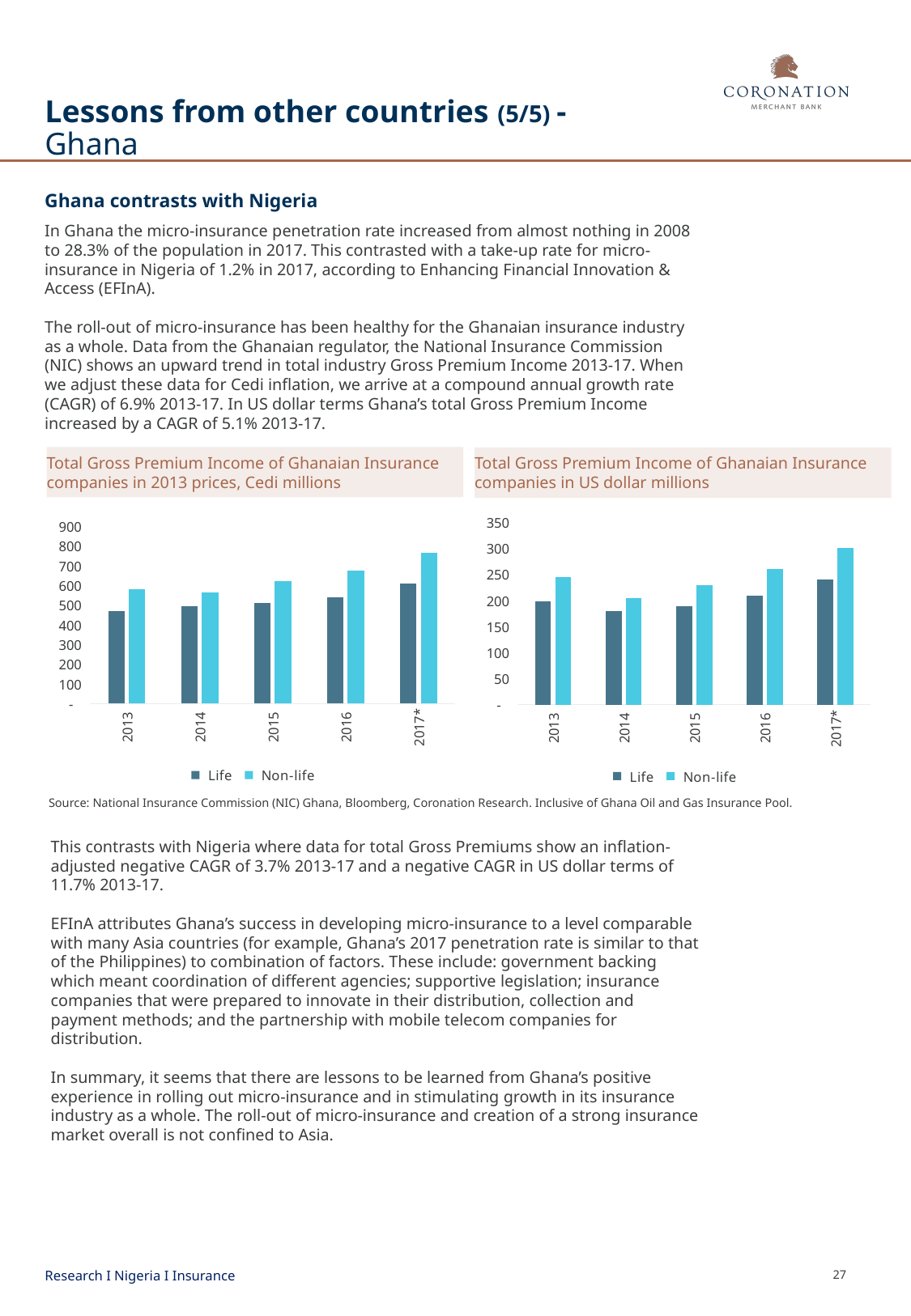
In the left chart (Cedi millions), which year has the highest Non-life value? 2017* In the right chart (US dollar millions), is the Life value for 2014 greater or less than 200? less In the left chart (Cedi millions), do the Life values generally rise or fall from 2013 to 2017*? Rise In the right chart (US dollar millions), which year has the highest Non-life value? 2017* How many series does the legend of the right chart, 'Total Gross Premium Income of Ghanaian Insurance companies in US dollar millions', list? 2 In the left chart (Cedi millions), which year has the lowest Life value? 2013 In the right chart (US dollar millions), which is larger in 2016: Life or Non-life? Non-life What kind of chart is the left chart, 'Total Gross Premium Income of Ghanaian Insurance companies in 2013 prices, Cedi millions'? Bar chart How many years are shown on the x axis of the left chart (Cedi millions)? 5 In the right chart (US dollar millions), which year has the lowest Life value? 2014 In the left chart (Cedi millions), is the Non-life value for 2017* greater or less than 700? greater What are the two legend entries in the left chart (Cedi millions)? Life and Non-life